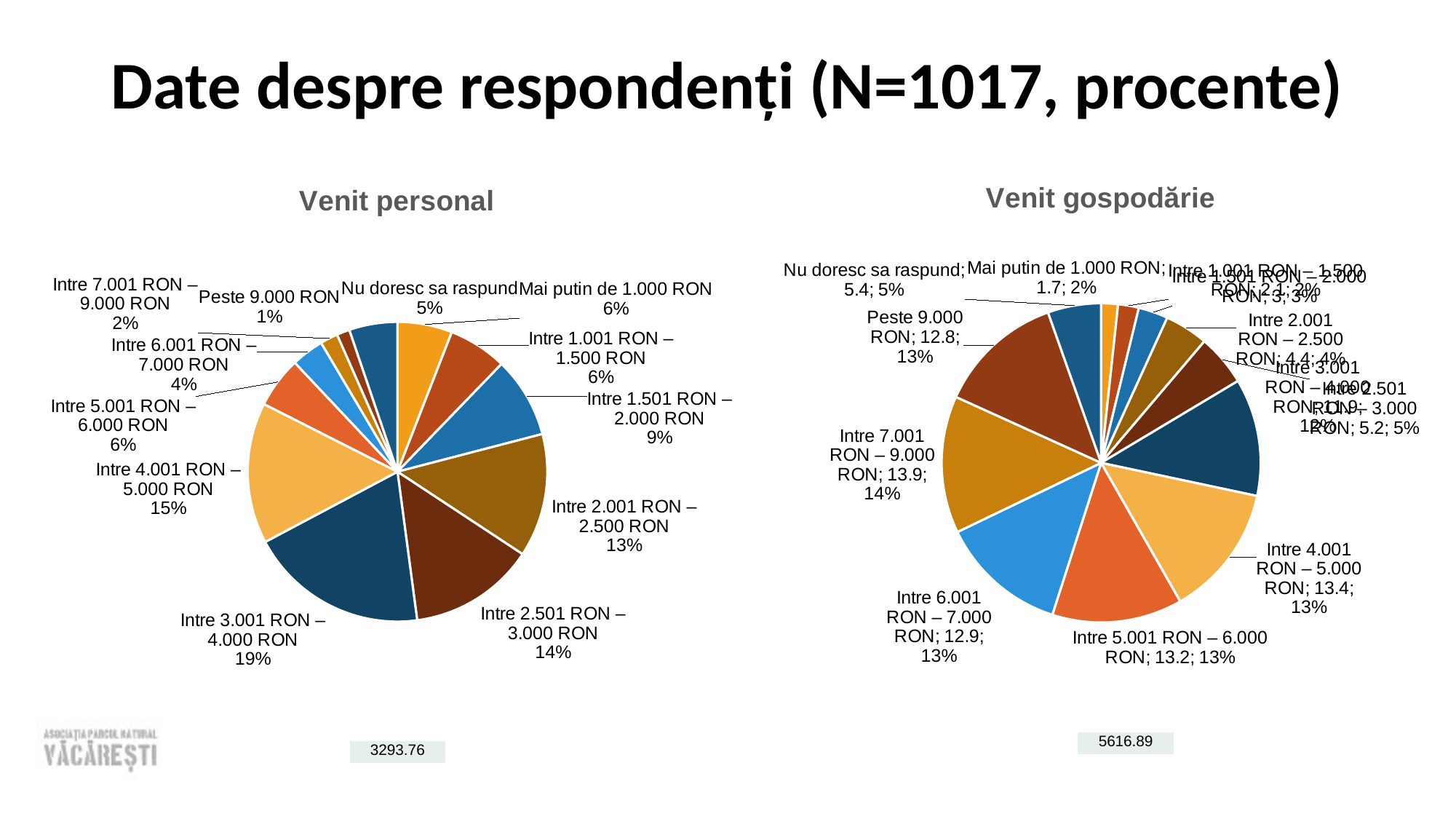
In the 'Venit personal' chart, what percentage is shown for 'Intre 3.001 RON – 4.000 RON'? 19% In the 'Venit personal' chart, what is the difference in percentage points between 'Intre 3.001 RON – 4.000 RON' and 'Intre 4.001 RON – 5.000 RON'? 4 In the 'Venit gospodărie' chart, which is larger: 'Intre 5.001 RON – 6.000 RON' or 'Intre 2.001 RON – 2.500 RON'? Intre 5.001 RON – 6.000 RON How many categories does the 'Venit personal' pie chart have? 12 In the 'Venit personal' chart, which category has the largest share? Intre 3.001 RON – 4.000 RON In the 'Venit gospodărie' chart, what value is shown for 'Intre 7.001 RON – 9.000 RON'? 13.9 In the 'Venit personal' chart, which category has the smallest share? Peste 9.000 RON What is the title of the pie chart on the left of the slide? Venit personal What type of chart is 'Venit gospodărie'? Pie chart In the 'Venit personal' chart, what percentage is shown for 'Intre 1.501 RON – 2.000 RON'? 9% In the 'Venit personal' chart, which is larger: 'Intre 2.501 RON – 3.000 RON' or 'Intre 2.001 RON – 2.500 RON'? Intre 2.501 RON – 3.000 RON In the 'Venit gospodărie' chart, what value is shown for 'Nu doresc sa raspund'? 5.4